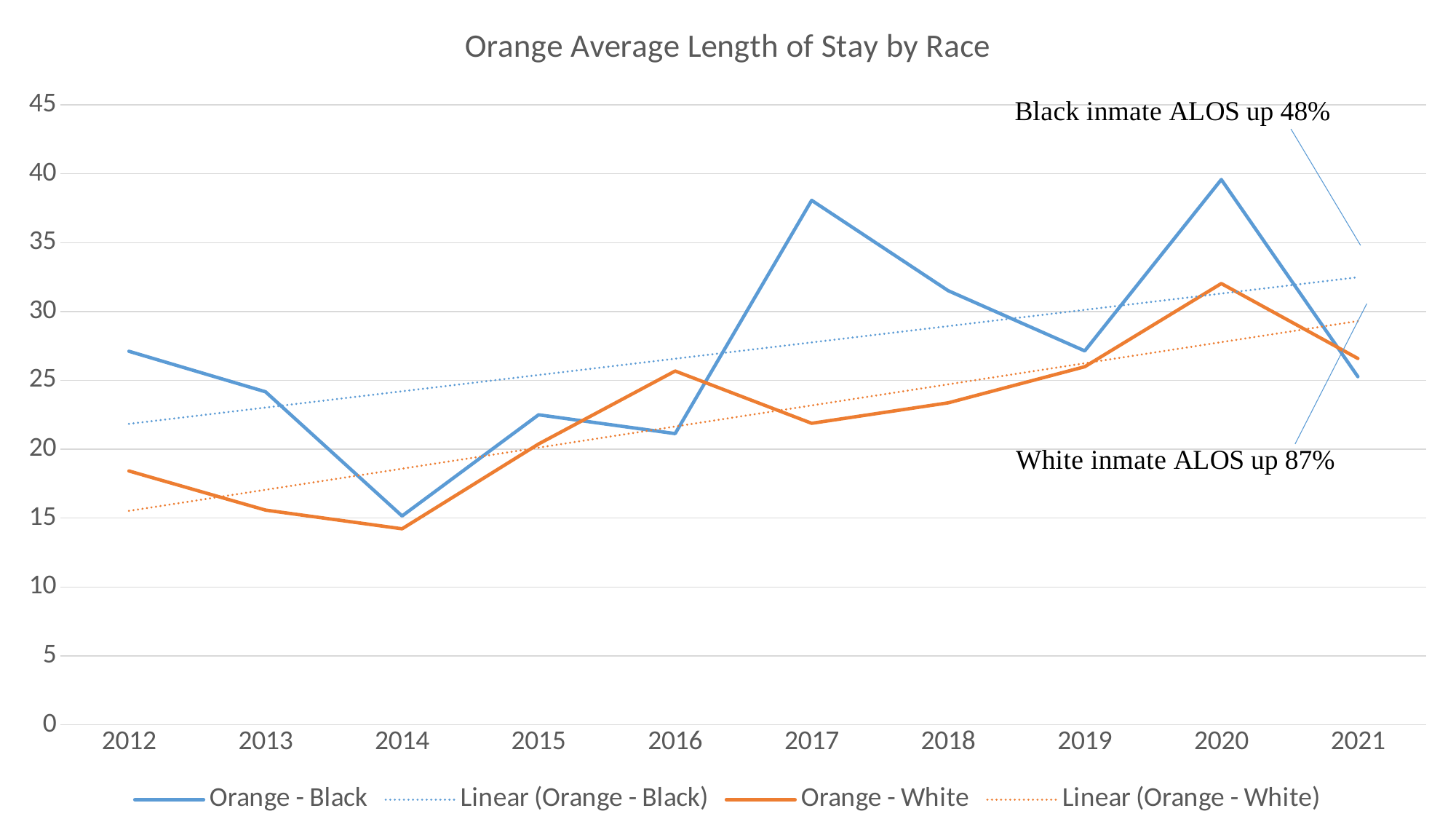
In 2016, which series has the larger value, Orange - Black or Orange - White? Orange - White Is the value for Orange - Black in 2017 greater or less than 35? greater What type of chart is shown on the slide? Line chart What is the title of the chart? Orange Average Length of Stay by Race In which year does the Orange - White series reach its highest value? 2020 Is the value for Orange - White in 2012 greater or less than 20? less According to the annotation on the chart, by what percentage is Black inmate ALOS up? 48% In which year does the Orange - Black series reach its highest value? 2020 How many entries does the legend list? 4 How many years are shown on the x axis? 10 Does the Linear (Orange - White) trendline rise or fall from 2012 to 2021? Rise In which year does the Orange - Black series reach its lowest value? 2014